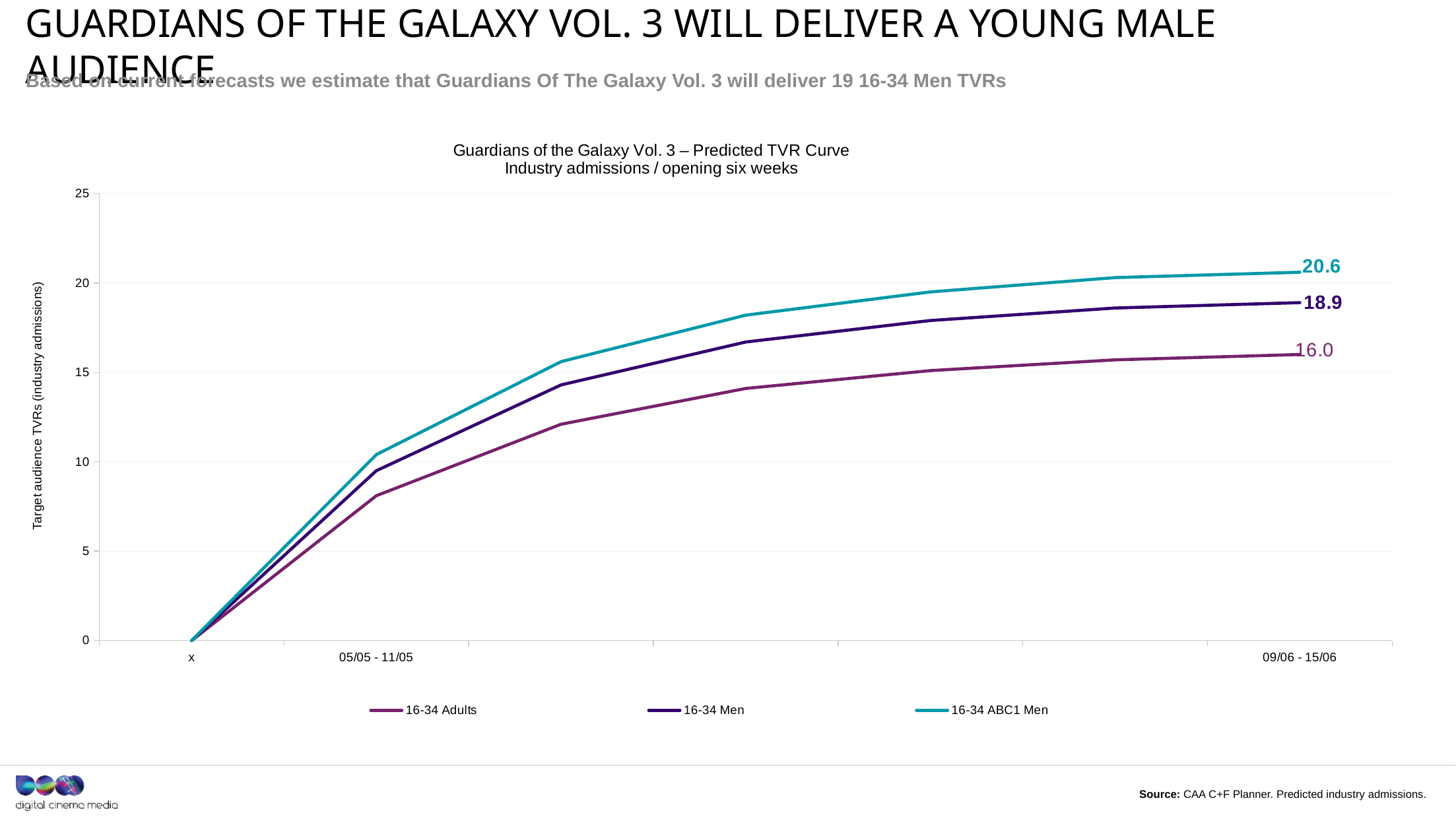
What kind of chart is shown? line chart Do the values rise or fall along the x axis? rise What is the final value for 16-34 Men at 09/06 - 15/06? 18.9 What is the final value for 16-34 ABC1 Men at 09/06 - 15/06? 20.6 What is the final value for 16-34 Adults at 09/06 - 15/06? 16.0 Which is larger at 09/06 - 15/06: 16-34 Men or 16-34 Adults? 16-34 Men What is the difference between the final values for 16-34 ABC1 Men and 16-34 Adults? 4.6 How many series does the legend list? 3 Which series has the highest value at 09/06 - 15/06? 16-34 ABC1 Men What is the difference between the final values for 16-34 Men and 16-34 Adults? 2.9 Which series has the lowest value at 09/06 - 15/06? 16-34 Adults Is the value for 16-34 Adults at 05/05 - 11/05 greater or less than 10? less